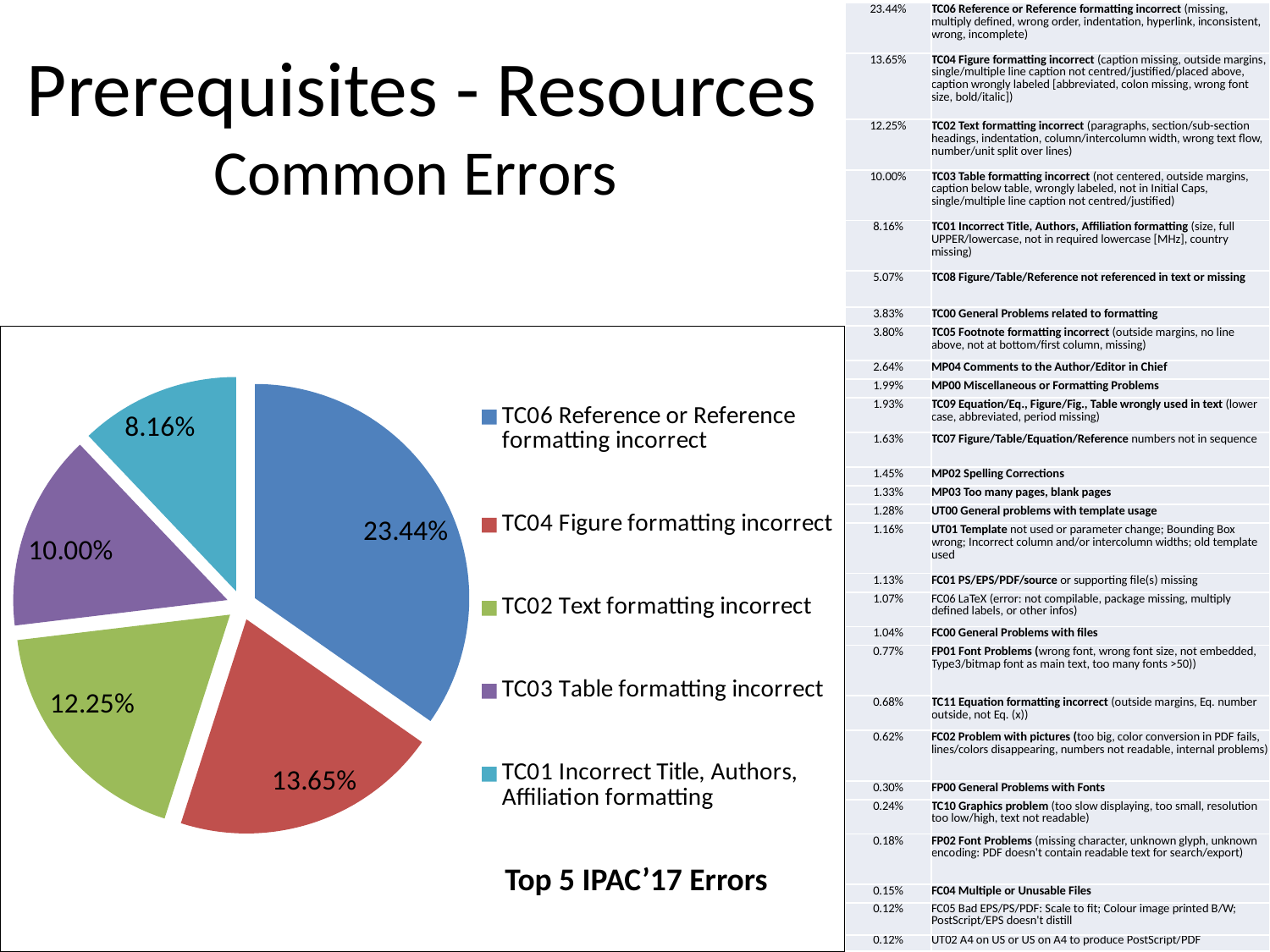
What is the value shown for TC02 Text formatting incorrect? 12.25% What is the difference between the values for TC06 Reference or Reference formatting incorrect and TC04 Figure formatting incorrect? 9.79% Which is larger, the value for TC02 Text formatting incorrect or TC03 Table formatting incorrect? TC02 Text formatting incorrect What is the value shown for TC04 Figure formatting incorrect? 13.65% What is the title of the chart? Top 5 IPAC'17 Errors How many slices does the pie chart have? 5 Which category has the smallest slice of the pie? TC01 Incorrect Title, Authors, Affiliation formatting Which category has the largest slice of the pie? TC06 Reference or Reference formatting incorrect What is the value shown for TC06 Reference or Reference formatting incorrect? 23.44% What is the value shown for TC01 Incorrect Title, Authors, Affiliation formatting? 8.16% What kind of chart is shown on the slide? pie chart What is the value shown for TC03 Table formatting incorrect? 10.00%